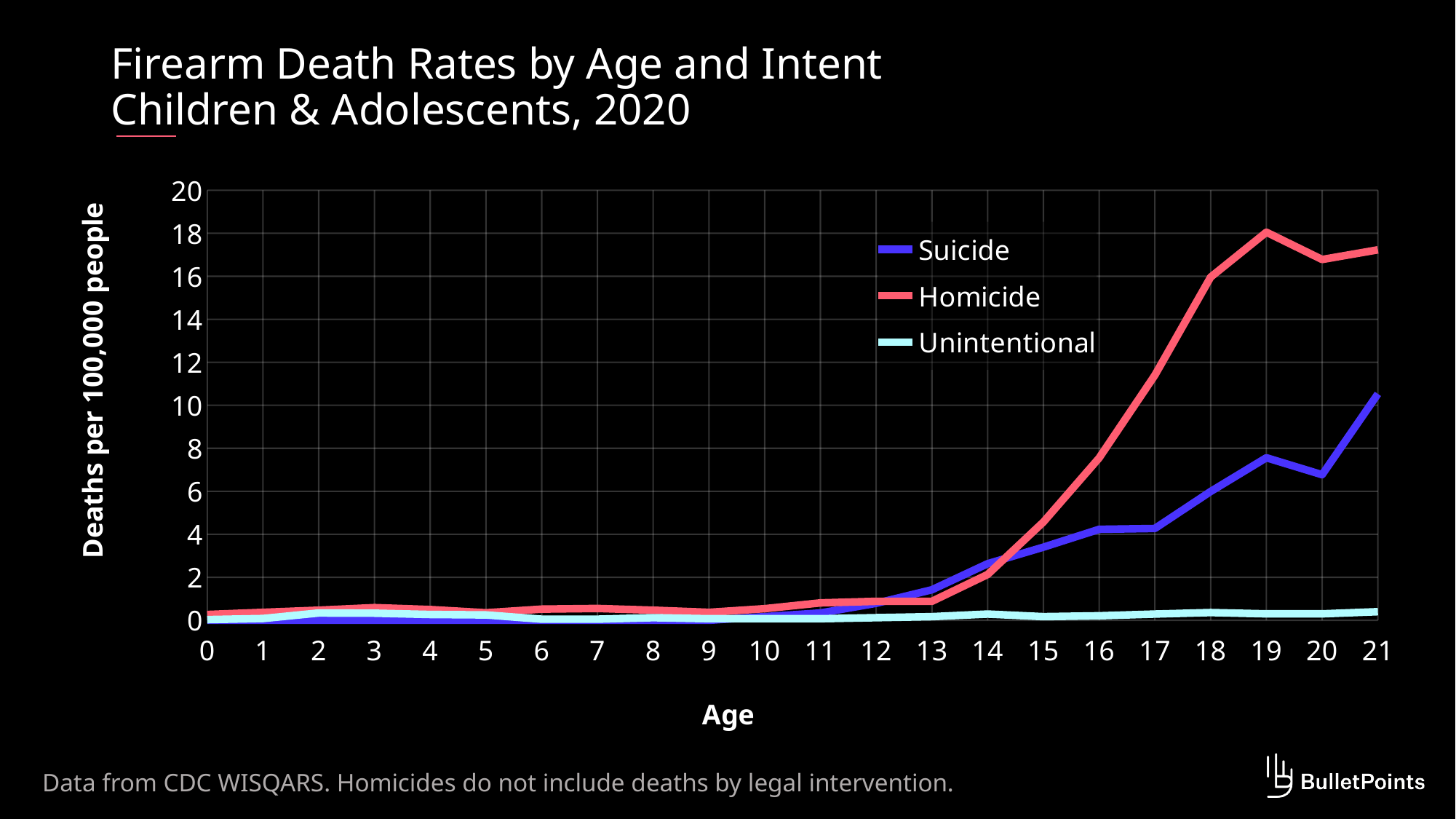
Which series has the highest value at age 19? Homicide How many series does the legend list? 3 What kind of chart is shown on the slide? line chart How many age points are plotted along the x axis? 22 What is the label of the y axis? Deaths per 100,000 people Which is larger at age 20, the Homicide value or the Suicide value? Homicide Which series has the lowest value at age 21? Unintentional Is the Homicide value at age 18 greater or less than 14? greater At which age does the Homicide line reach its highest value? 19 Does the Homicide line generally rise or fall between age 13 and age 19? rise Is the Suicide value at age 21 greater or less than 10? greater Is the Suicide value at age 16 greater or less than 6? less